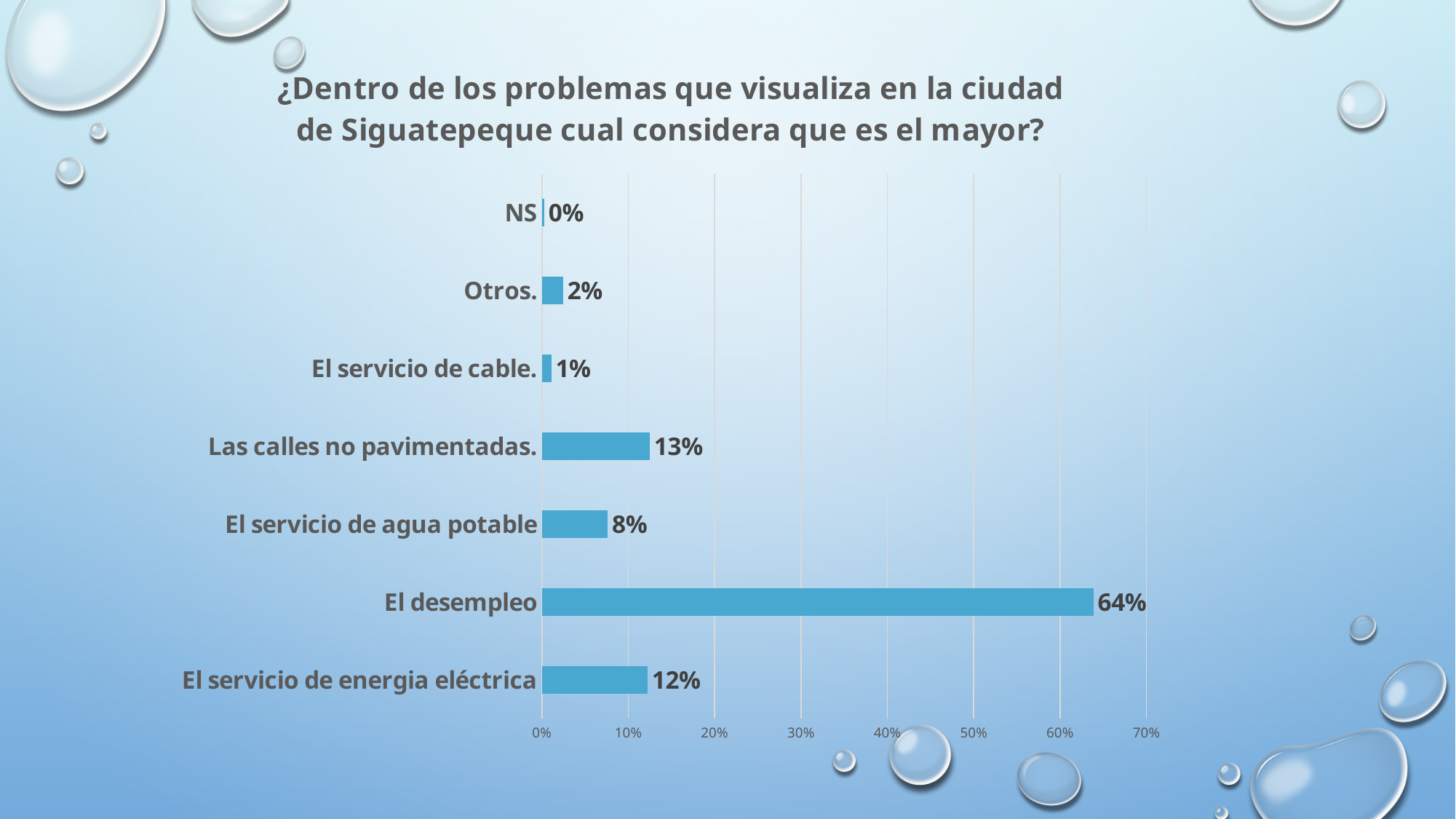
What is the value for Las calles no pavimentadas? 13% What is the difference between El desempleo and Las calles no pavimentadas? 51% Which category has the lowest value? NS Which is larger, Las calles no pavimentadas or El servicio de energia eléctrica? Las calles no pavimentadas What kind of chart is shown on the slide? bar chart What is the value for El desempleo? 64% What is the value for Otros? 2% What is the value for El servicio de energia eléctrica? 12% Which category has the highest value? El desempleo How many categories are shown in the chart? 7 What is the value for El servicio de agua potable? 8% Is the value for El desempleo greater or less than 60%? greater